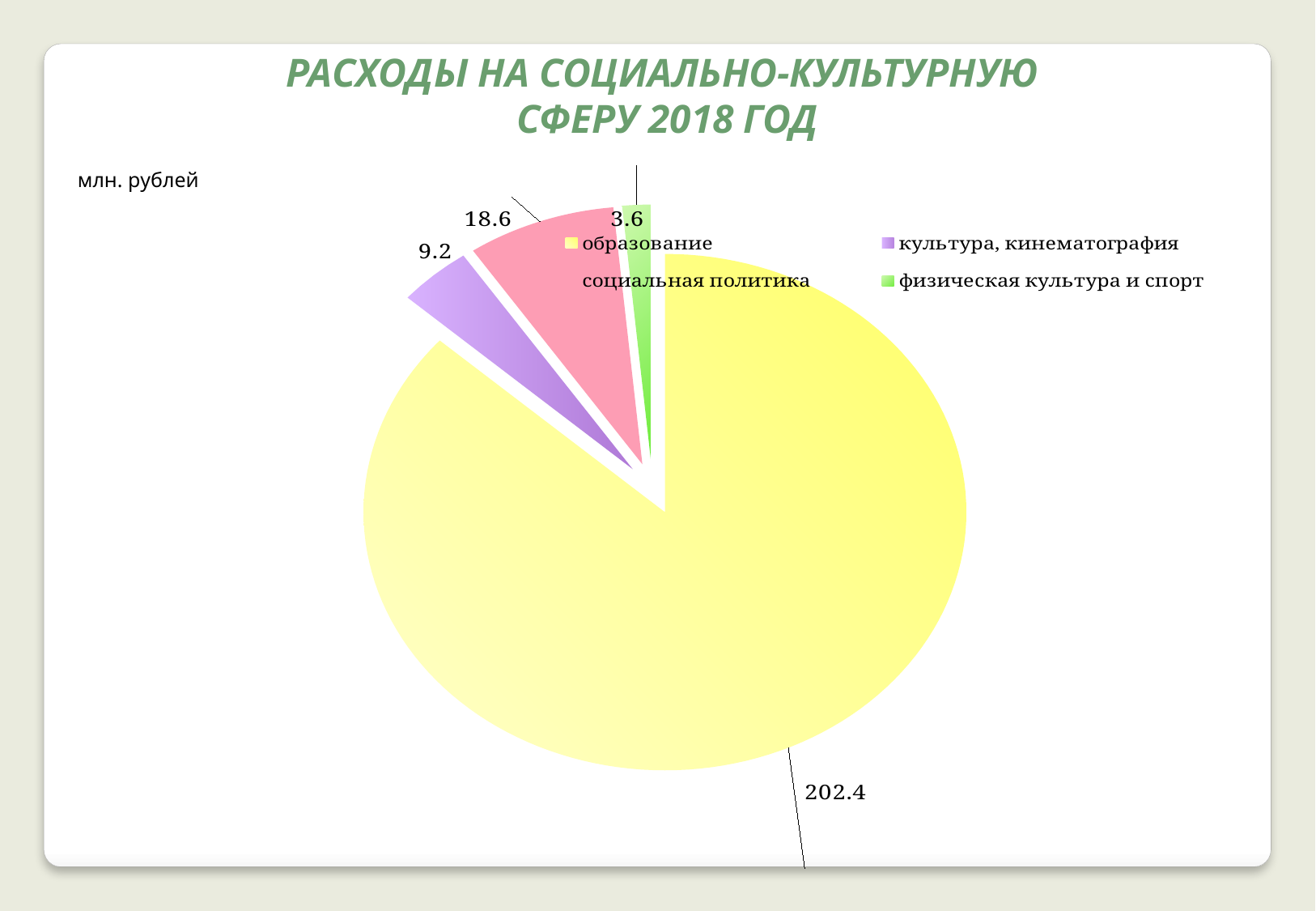
What is the value for культура, кинематография? 9.2 What unit of measurement is indicated on the slide for the chart values? млн. рублей Which is larger, the value for культура, кинематография or the value for физическая культура и спорт? культура, кинематография What is the value for физическая культура и спорт? 3.6 What is the difference between the values for образование and социальная политика? 183.8 What type of chart is shown on the slide? pie chart Which category has the largest slice of the pie? образование Which category has the smallest slice of the pie? физическая культура и спорт What is the difference between the values for социальная политика and культура, кинематография? 9.4 What is the value for социальная политика? 18.6 What is the value for образование? 202.4 How many categories does the pie chart have? 4